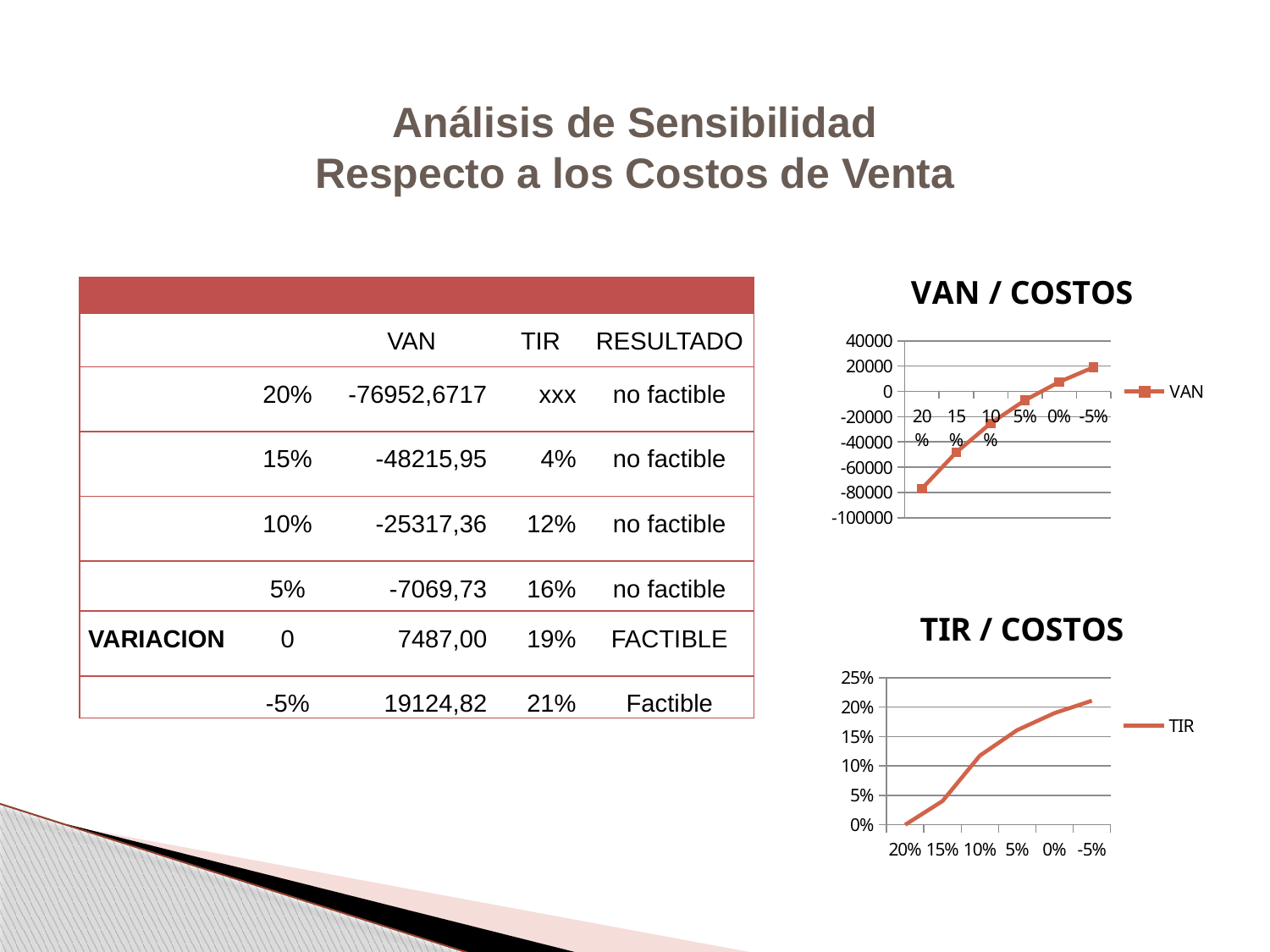
In the "TIR / COSTOS" chart, is the value for 15% greater or less than 10%? less In the "VAN / COSTOS" chart, is the value for 20% greater or less than -60000? less How many data points are plotted in the "TIR / COSTOS" chart? 6 In the "VAN / COSTOS" chart, do the values rise or fall moving left to right along the x axis? rise In the "VAN / COSTOS" chart, is the value for 10% greater or less than 0? less What kind of chart is the "VAN / COSTOS" chart? line chart In the "VAN / COSTOS" chart, which category has the lowest VAN value? 20% In the "VAN / COSTOS" chart, which category has the highest VAN value? -5% In the "TIR / COSTOS" chart, which category has the highest TIR value? -5% How many series does the legend of the "VAN / COSTOS" chart list? 1